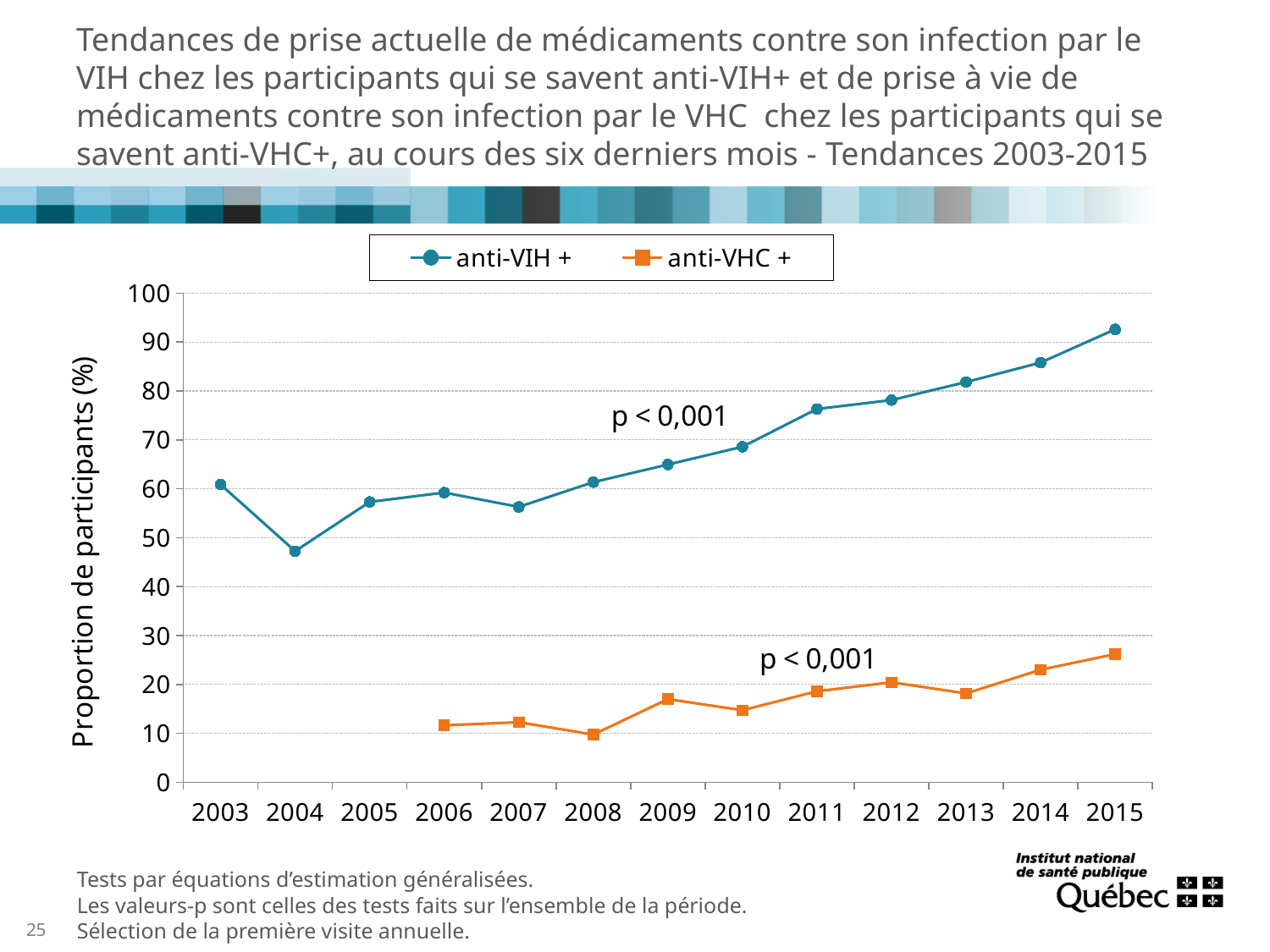
In which year is the anti-VHC + series at its lowest? 2008 Is the value for anti-VIH + in 2004 greater or less than 50? less In which year is the anti-VIH + series at its lowest? 2004 What kind of chart is shown on the slide? line chart Which series has the larger value in 2011, anti-VIH + or anti-VHC +? anti-VIH + In which year is the anti-VIH + series at its highest? 2015 Does the anti-VIH + series rise or fall from 2008 to 2015? rise In which year is the anti-VHC + series at its highest? 2015 Is the value for anti-VHC + in 2015 greater or less than 30? less Is the value for anti-VIH + in 2015 greater or less than 90? greater How many series does the legend list? 2 How many years are shown on the x axis? 13